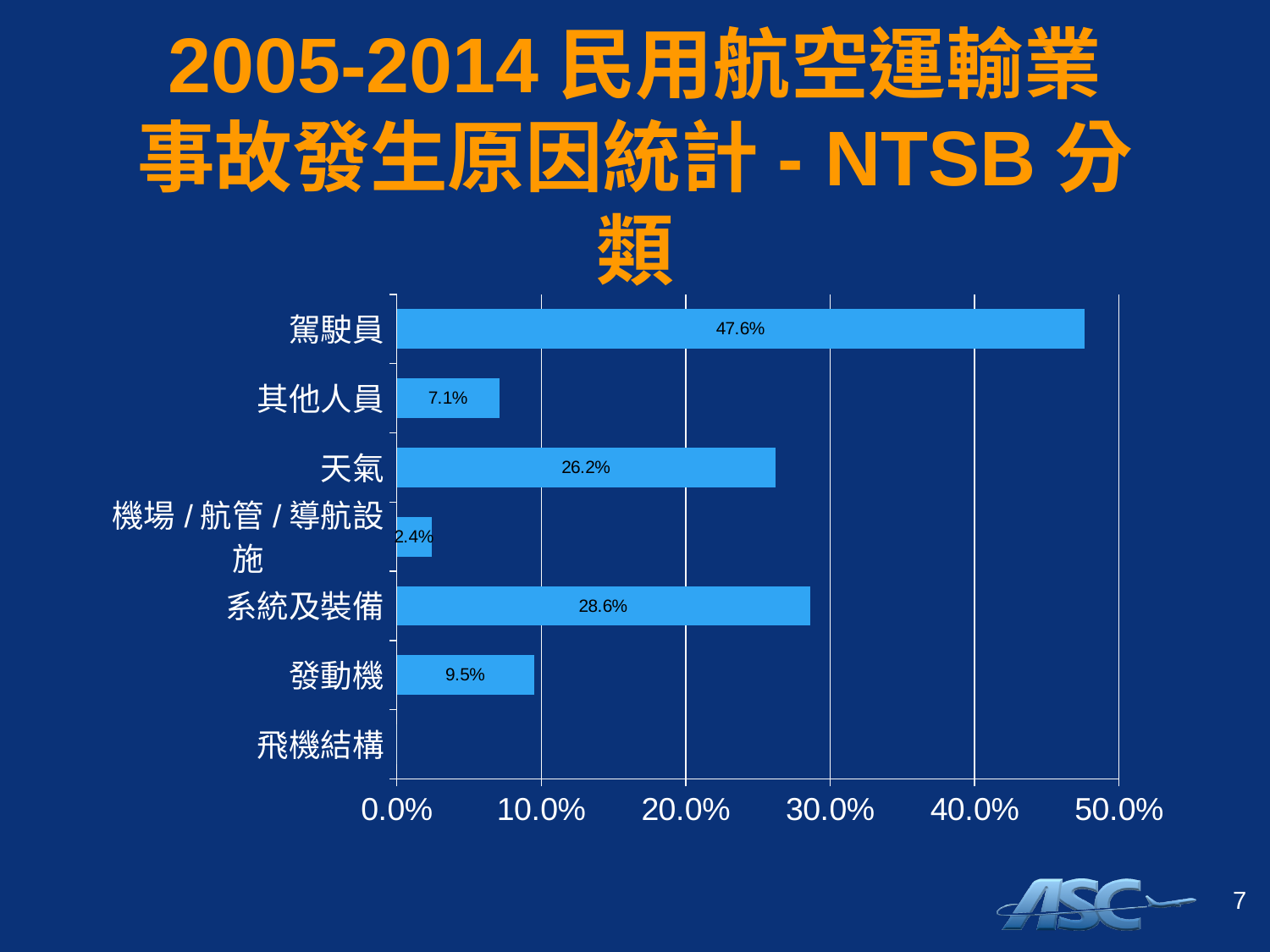
What is the difference between the values for 駕駛員 and 其他人員? 40.5% Which category with a labelled bar has the lowest value? 機場 / 航管 / 導航設施 Which is larger, the value for 發動機 or the value for 其他人員? 發動機 What is the value for 駕駛員? 47.6% Which category has the highest value? 駕駛員 How many categories are shown on the chart? 7 What is the value for 系統及裝備? 28.6% What is the value for 天氣? 26.2% Is the value for 駕駛員 greater or less than 40.0%? greater What is the value for 發動機? 9.5% What is the difference between the values for 系統及裝備 and 天氣? 2.4% What kind of chart is shown on the slide? bar chart